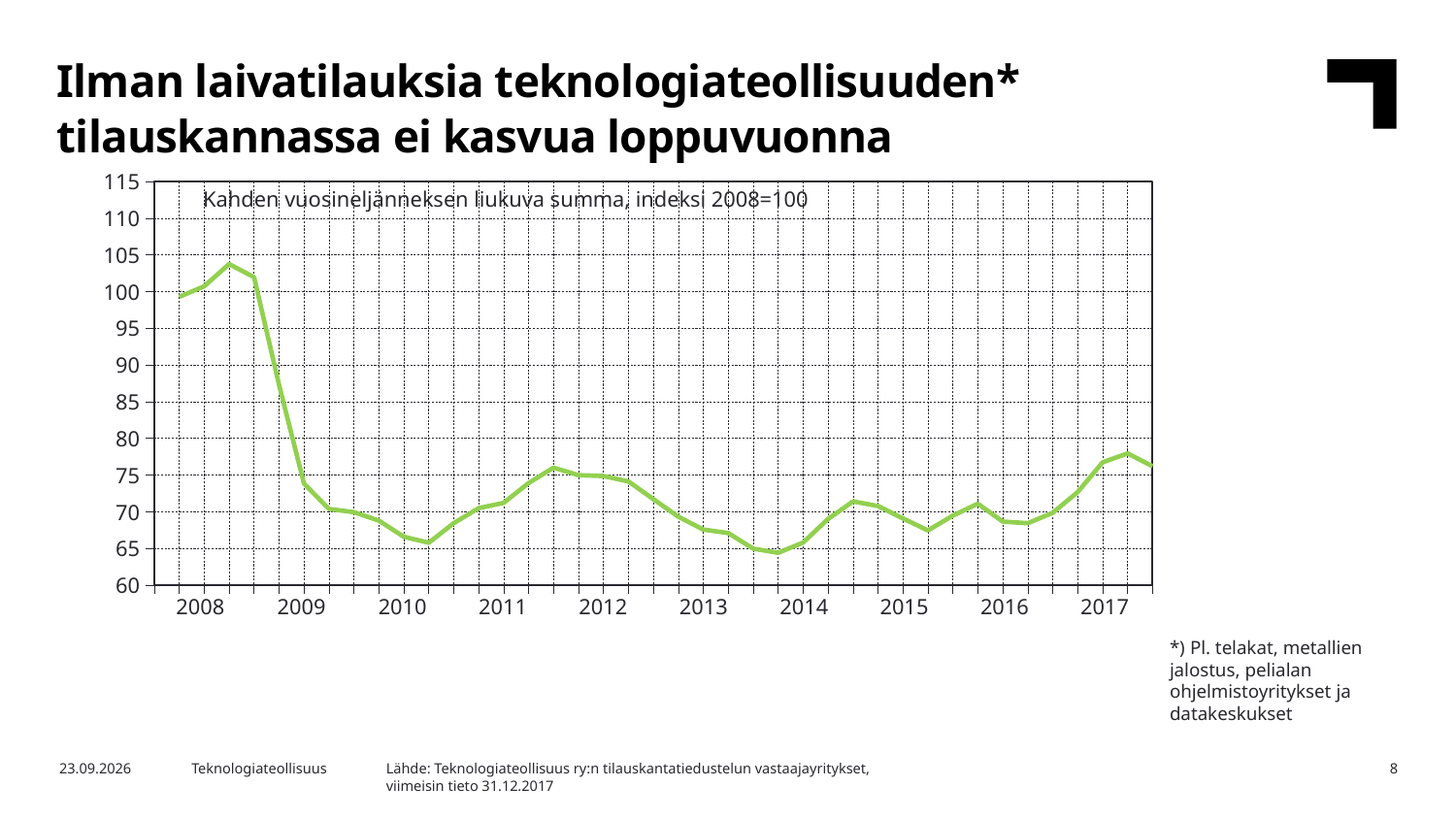
What kind of chart is shown on the slide? line chart What is the subtitle printed inside the chart area? Kahden vuosineljänneksen liukuva summa, indeksi 2008=100 Is the peak value in 2008 greater or less than 100? greater Does the line rise or fall between 2016 and 2017? rise How many years are labelled on the x axis? 10 Does the line rise or fall between 2008 and 2009? fall What is the first year labelled on the x axis? 2008 In which year does the line reach its highest point? 2008 Which is higher, the value at the start of 2008 or the value at the end of 2017? start of 2008 Is the lowest value in 2013 greater or less than 70? less Is the peak value in 2017 greater or less than 80? less